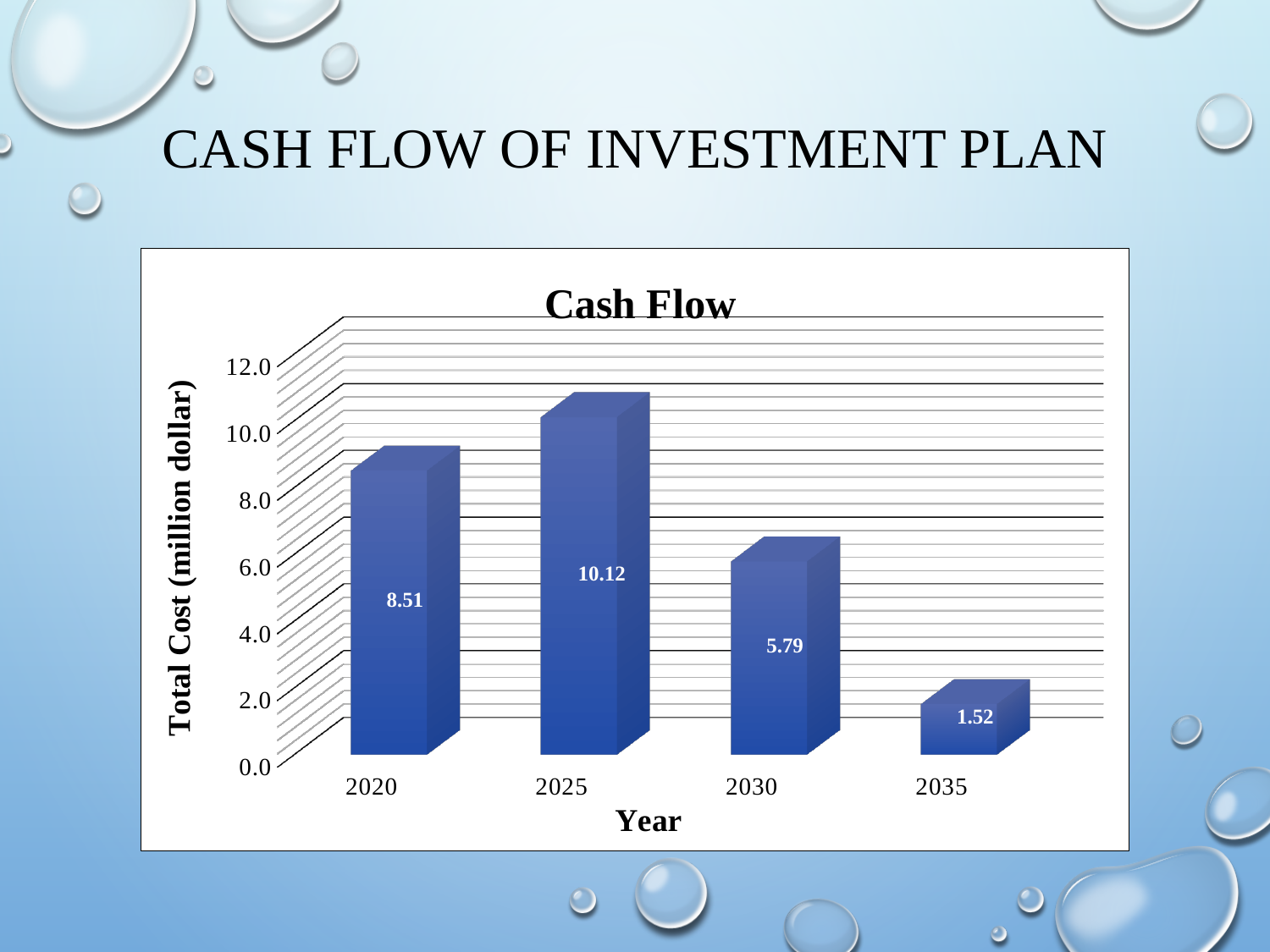
Which year has the lowest total cost? 2035 What is the total cost for 2025? 10.12 What is the total cost for 2030? 5.79 What is the title of the chart? Cash Flow What is the difference between the total cost in 2030 and in 2035? 4.27 Which year has the highest total cost? 2025 What is the difference between the total cost in 2025 and in 2020? 1.61 What is the total cost for 2035? 1.52 What kind of chart is shown? Bar chart How many years are shown on the x axis? 4 What is the total cost for 2020? 8.51 Which year has a larger total cost, 2020 or 2030? 2020